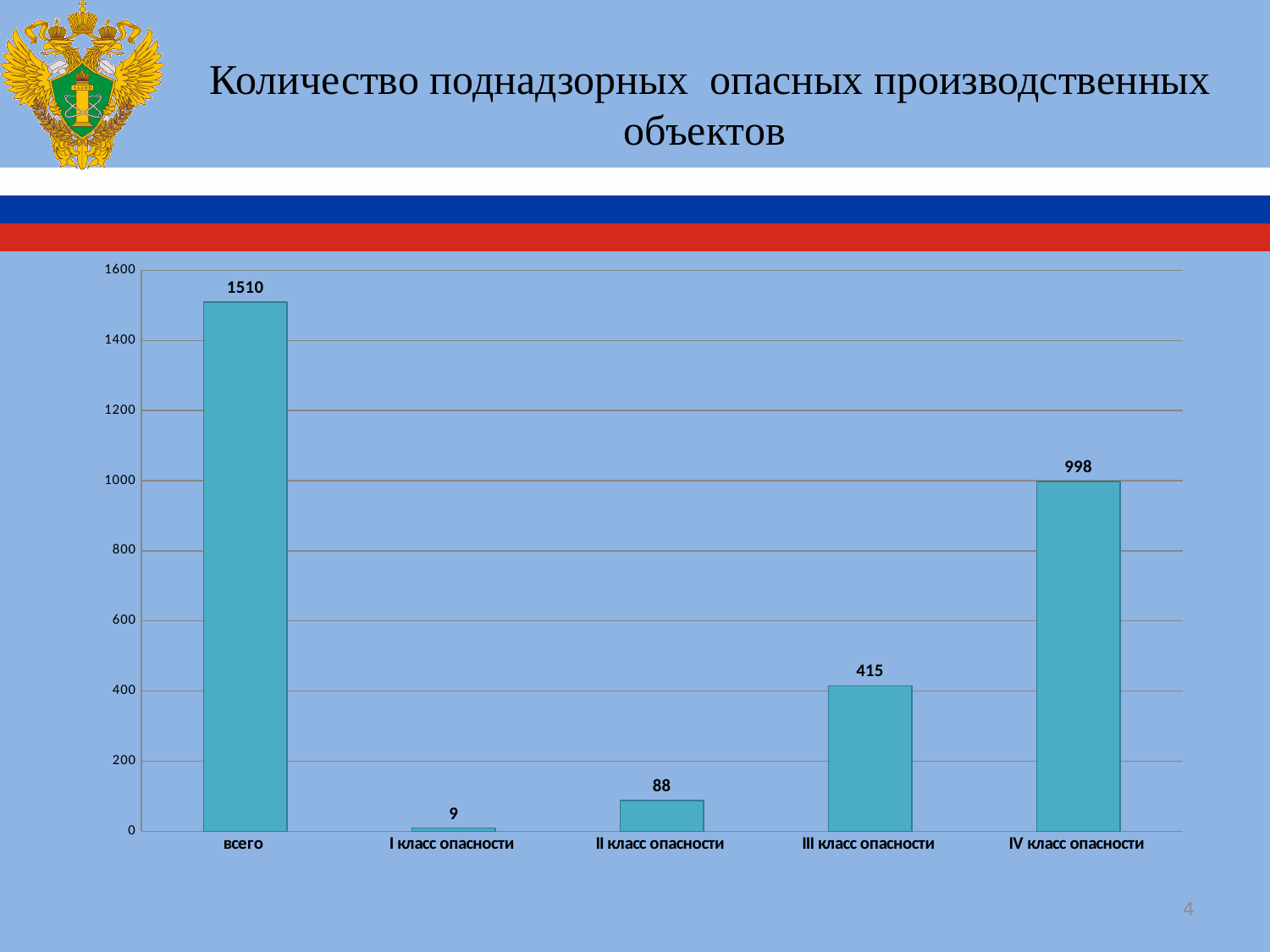
What is the value for II класс опасности? 88 What is the value for III класс опасности? 415 What is the value for I класс опасности? 9 What is the value for всего? 1510 Which category has the lowest value? I класс опасности Which category has the highest value? всего How many categories are shown on the x axis? 5 Which is larger, the value for II класс опасности or III класс опасности? III класс опасности What kind of chart is shown on the slide? bar chart What is the value for IV класс опасности? 998 What is the difference between the values for IV класс опасности and III класс опасности? 583 What is the title of the slide? Количество поднадзорных опасных производственных объектов